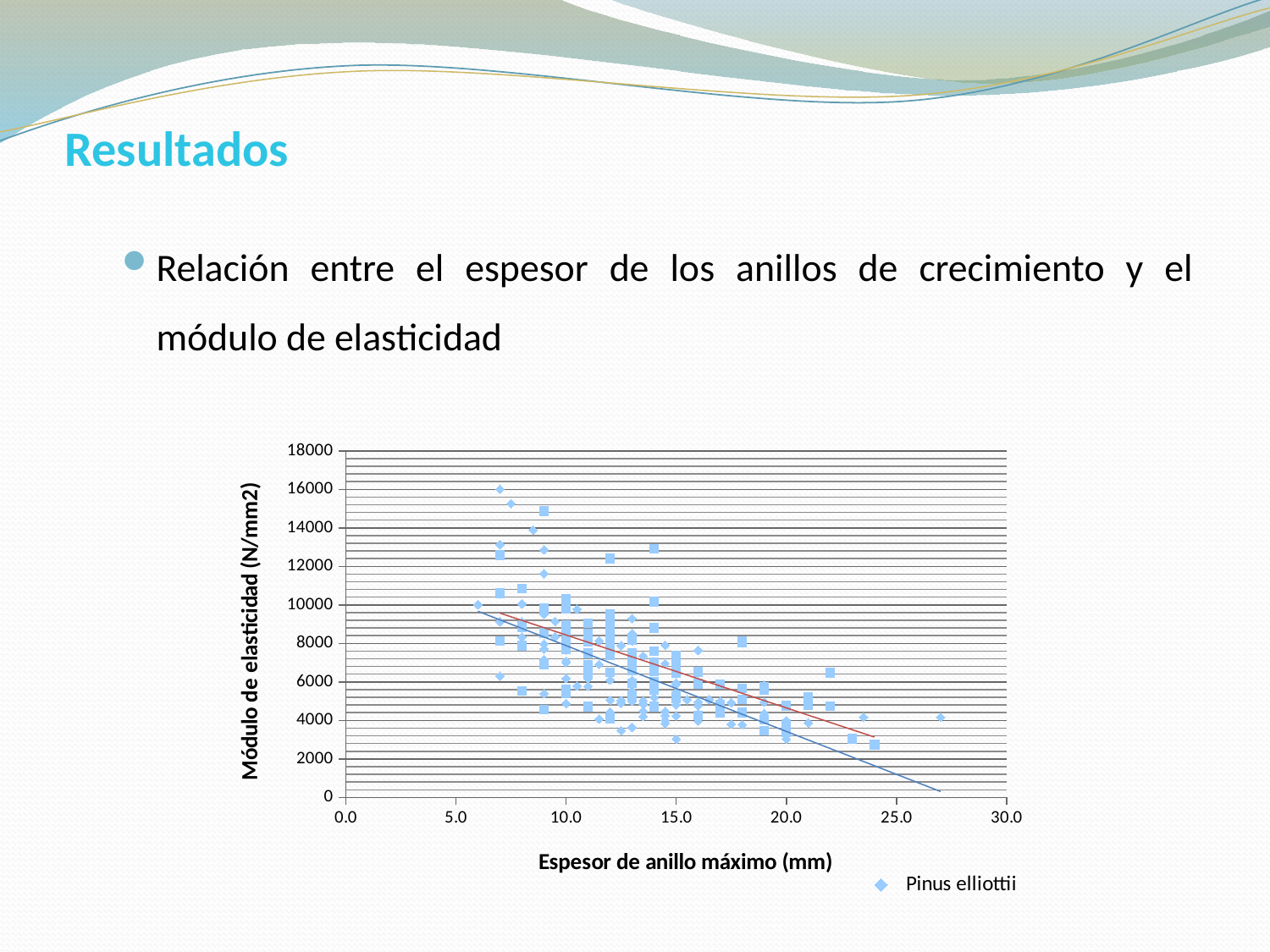
What is the name of the series shown in the chart legend? Pinus elliottii How many series does the chart legend list? 1 What is the maximum value shown on the horizontal axis of the chart? 30.0 As the ring thickness (x axis) increases, do the modulus of elasticity values generally rise or fall? fall Is the highest plotted modulus of elasticity value greater or less than 14000? greater Do the points with ring thickness above 20 mm generally have higher or lower modulus of elasticity than the points with ring thickness below 10 mm? lower Is the modulus of elasticity for the point with the largest ring thickness (around 27 mm) greater or less than 6000? less What is the title of the horizontal axis of the chart? Espesor de anillo máximo (mm) Is the modulus of elasticity for the point with the largest ring thickness (around 27 mm) greater or less than 2000? greater What kind of chart is shown on the slide? scatter chart What is the maximum value shown on the vertical axis of the chart? 18000